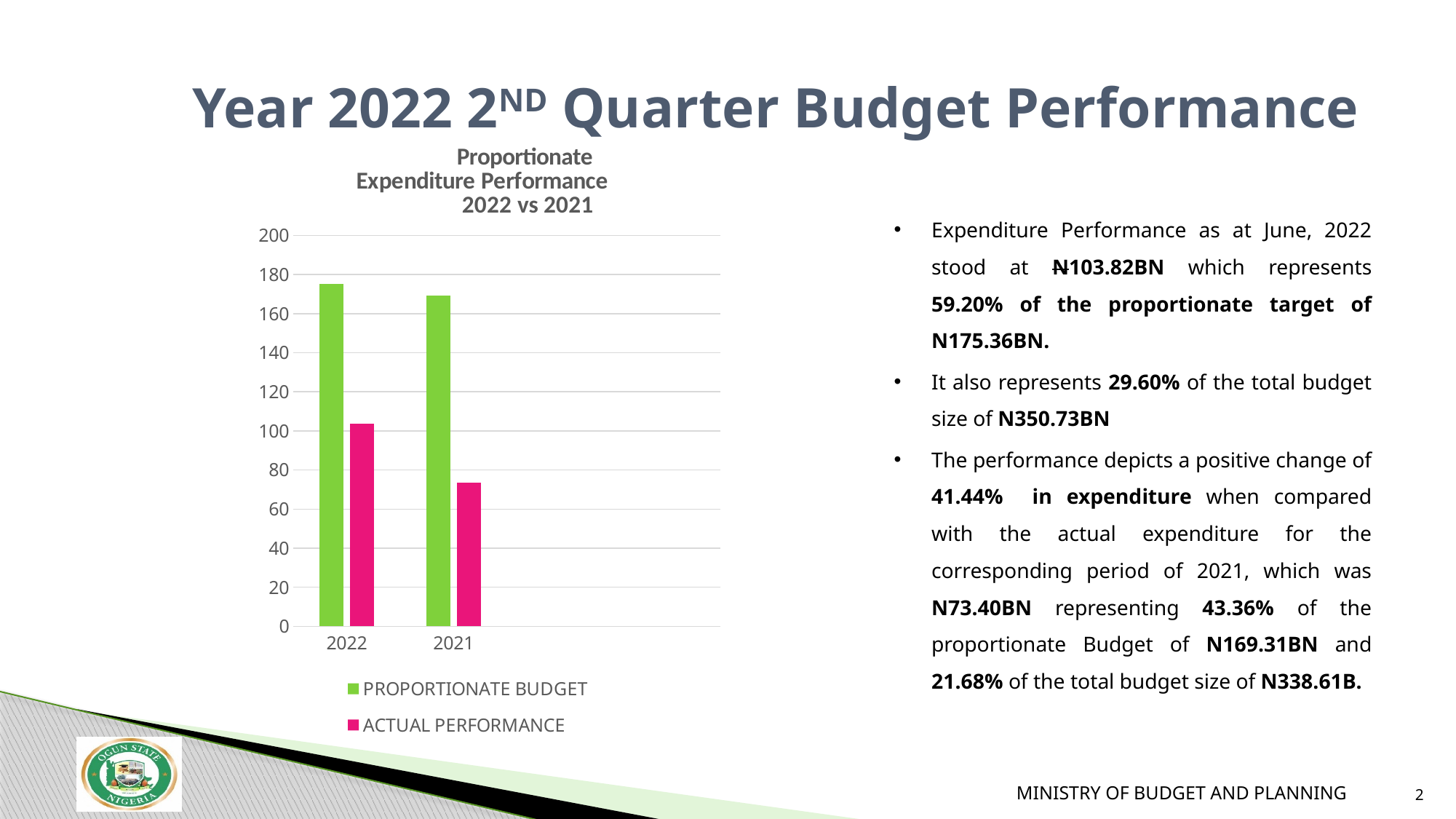
Is the PROPORTIONATE BUDGET value for 2021 greater or less than 140? greater Which colour represents ACTUAL PERFORMANCE in the chart? pink Is the ACTUAL PERFORMANCE value for 2022 greater or less than 120? less Is the ACTUAL PERFORMANCE value for 2021 greater or less than 80? less What is the title of the chart? Proportionate Expenditure Performance 2022 vs 2021 Which bar in the chart is the tallest? PROPORTIONATE BUDGET for 2022 How many categories are shown on the x axis of the chart? 2 How many series does the chart legend list? 2 Which bar in the chart is the shortest? ACTUAL PERFORMANCE for 2021 What kind of chart is shown on the slide? bar chart Is the ACTUAL PERFORMANCE value for 2022 larger or smaller than the ACTUAL PERFORMANCE value for 2021? larger